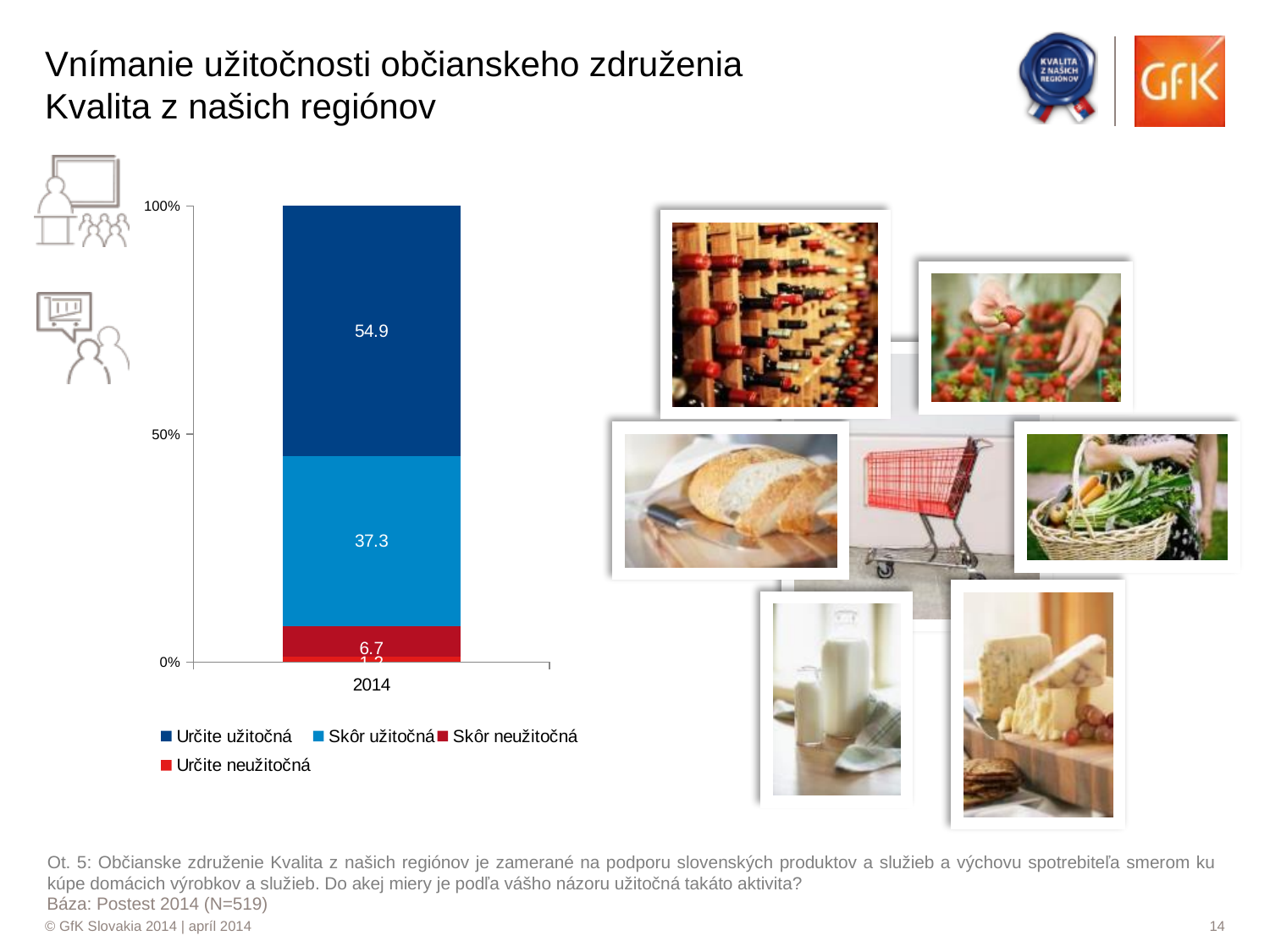
What kind of chart is shown on the slide? Stacked bar chart How many categories are shown on the x axis? 1 What is the value for Skôr neužitočná in 2014? 6.7 What is the value for Skôr užitočná in 2014? 37.3 Which series has the smallest segment in the 2014 bar? Určite neužitočná What is the value for Určite užitočná in 2014? 54.9 What is the difference between the values for Skôr užitočná and Skôr neužitočná? 30.6 Which is larger, the value for Určite užitočná or the value for Skôr užitočná? Určite užitočná Is the value for Určite užitočná greater or less than 50? greater What is the difference between the values for Určite užitočná and Skôr užitočná? 17.6 How many series does the legend list? 4 Which series has the largest segment in the 2014 bar? Určite užitočná